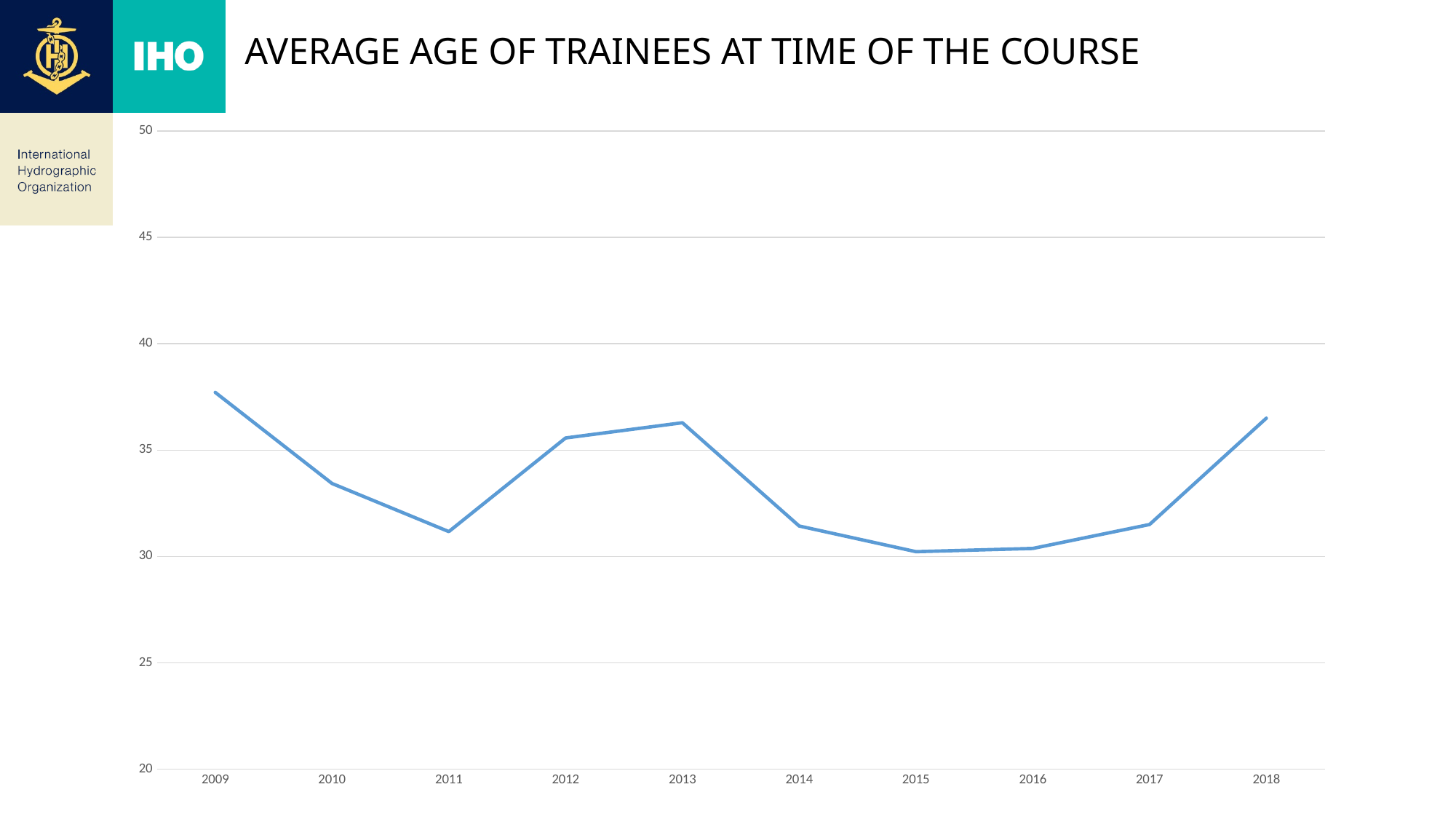
What kind of chart is shown on the slide? line chart Does the average age rise or fall from 2009 to 2011? fall What is the title of the chart? AVERAGE AGE OF TRAINEES AT TIME OF THE COURSE Is the average age for 2015 greater or less than 35? less Which year has the highest average age of trainees? 2009 Is the average age for 2009 greater or less than 35? greater Which year has the larger average age, 2009 or 2011? 2009 Does the average age rise or fall from 2015 to 2018? rise Is the average age for 2018 greater or less than 35? greater Which year has the larger average age, 2012 or 2014? 2012 How many years are plotted along the x axis? 10